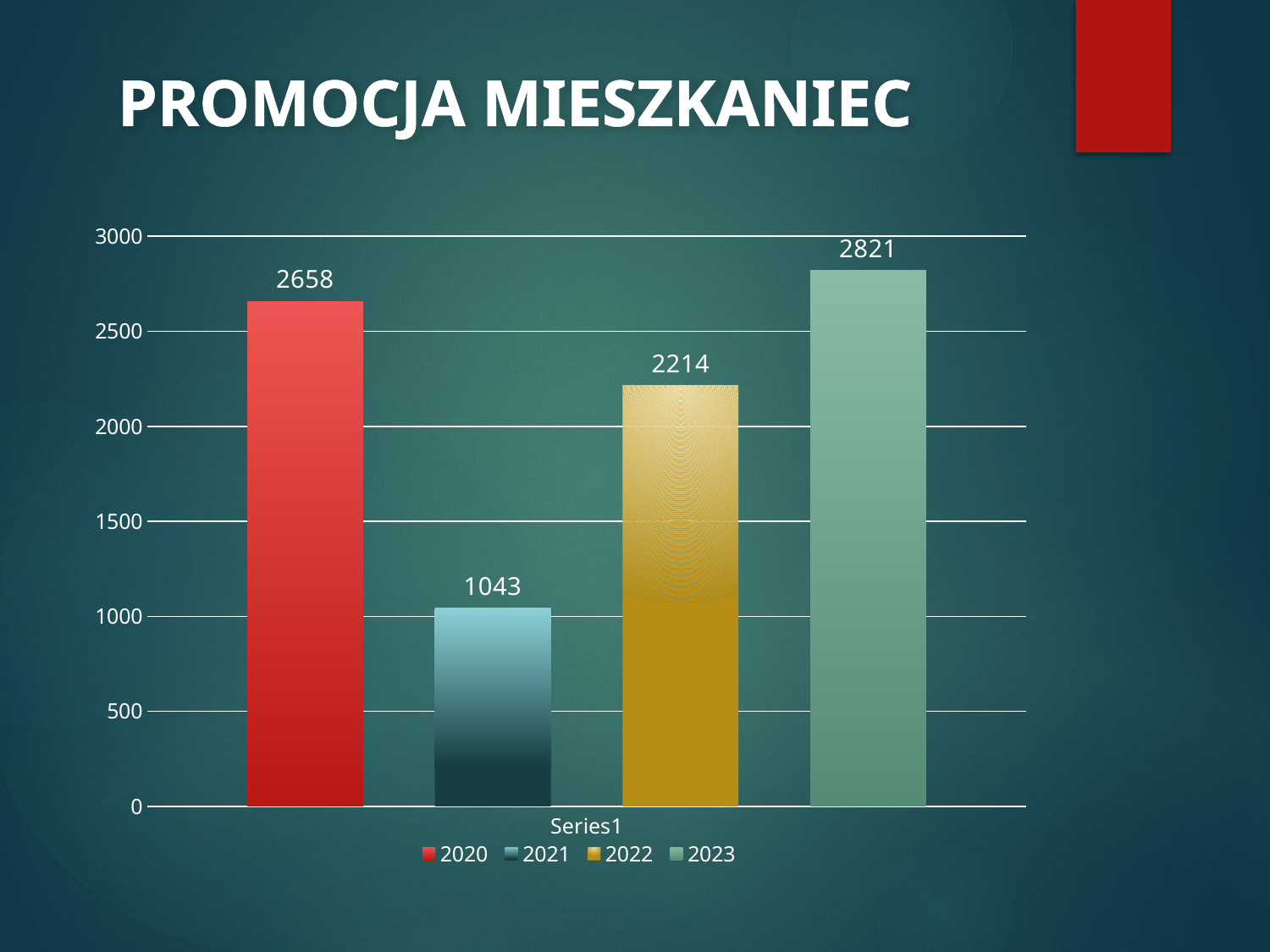
Which is larger, the value for 2020 or the value for 2022? 2020 How many series does the legend list? 4 What is the value for 2022? 2214 What is the title of the slide containing the chart? PROMOCJA MIESZKANIEC What is the value for 2020? 2658 What is the value for 2023? 2821 What is the value for 2021? 1043 Which year has the highest value? 2023 What is the difference between the values for 2023 and 2020? 163 What kind of chart is shown on the slide? bar chart Which year has the lowest value? 2021 What is the difference between the values for 2022 and 2021? 1171